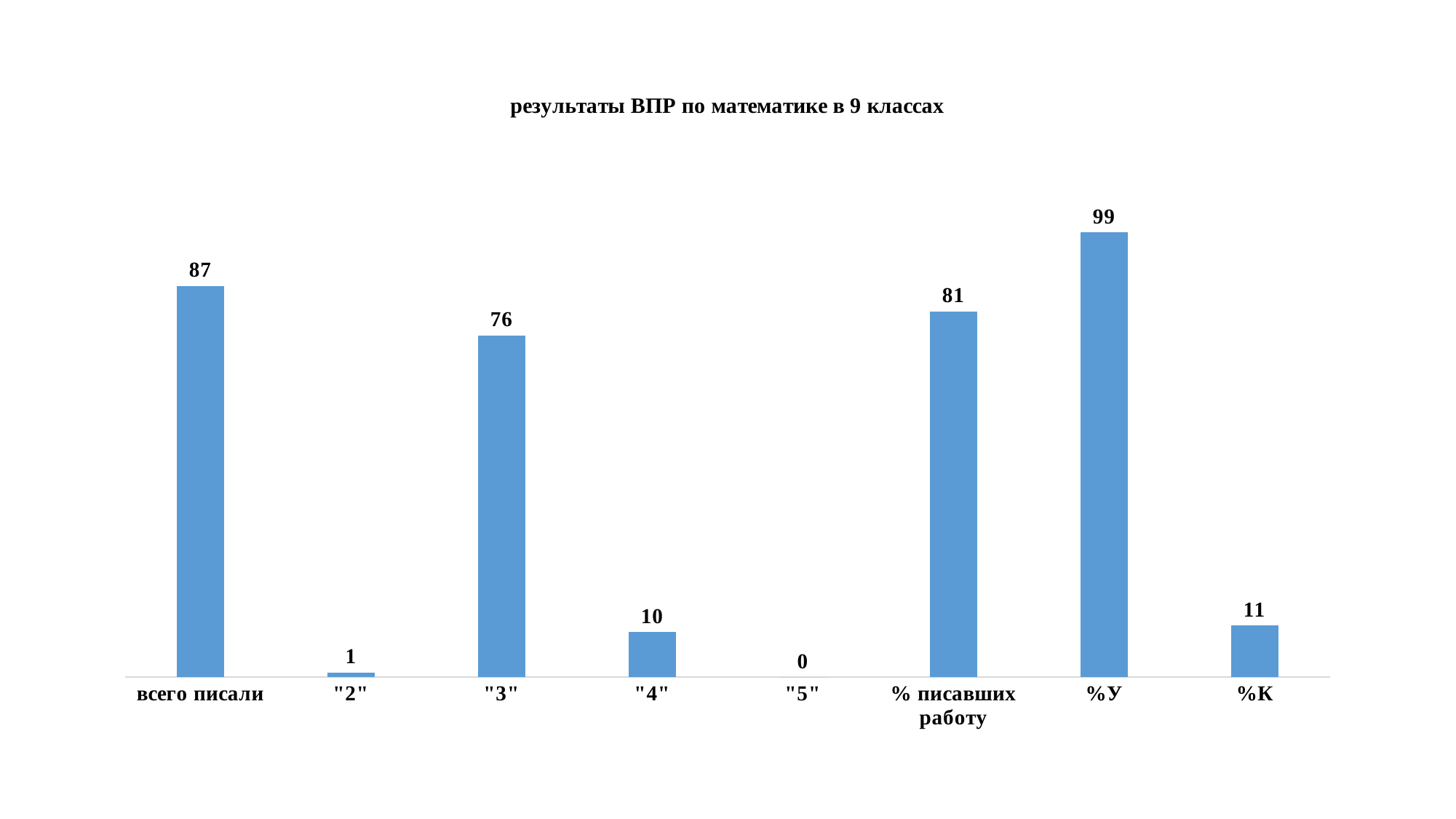
What is the value for "%У"? 99 What is the title of the chart? результаты ВПР по математике в 9 классах What kind of chart is this? bar chart What is the difference between the values for "всего писали" and "3"? 11 Which category has the highest value? %У What is the value for "всего писали"? 87 What is the value for "5"? 0 How many categories are shown on the x axis? 8 Which category has the lowest value? "5" What is the value for "% писавших работу"? 81 Which is larger, the value for "4" or the value for "%К"? %К What is the value for "3"? 76